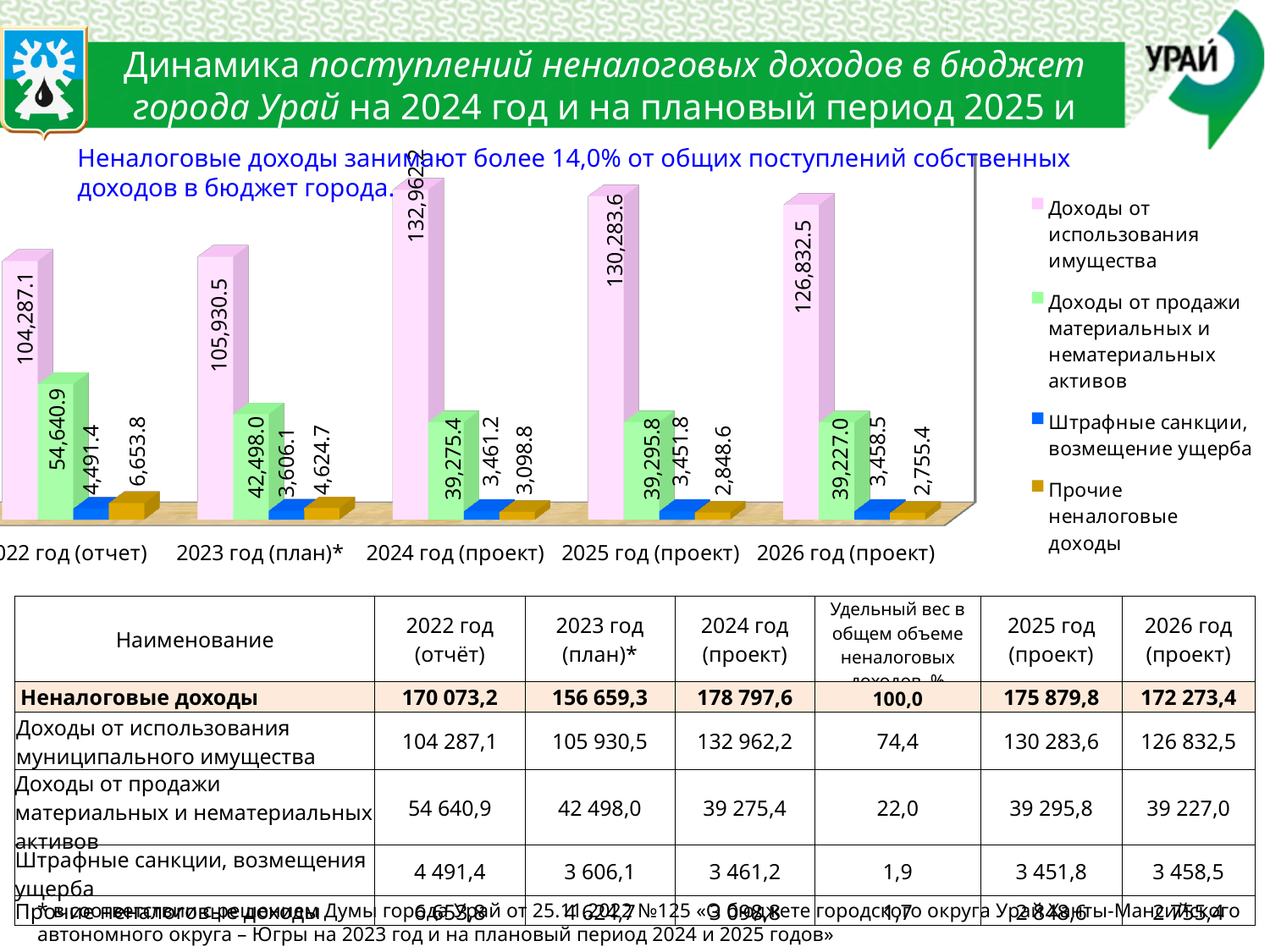
What is the value of Штрафные санкции, возмещение ущерба for 2026 год (проект)? 3,458.5 How many year categories are shown on the chart's x axis? 5 What is the value of Доходы от использования имущества for 2024 год (проект)? 132,962.2 What is the value of Прочие неналоговые доходы for 2025 год (проект)? 2,848.6 Does Прочие неналоговые доходы rise or fall from 2023 год (план)* to 2026 год (проект)? Fall How many series does the chart legend list? 4 What type of chart is shown on the slide? Bar chart What is the value of Доходы от продажи материальных и нематериальных активов for 2023 год (план)*? 42,498.0 What is the difference between Доходы от использования имущества in 2024 год (проект) and 2025 год (проект)? 2,678.6 Which is larger in 2026 год (проект): Штрафные санкции, возмещение ущерба or Прочие неналоговые доходы? Штрафные санкции, возмещение ущерба In which year is Прочие неналоговые доходы the lowest? 2026 год (проект) In which year is Доходы от использования имущества the highest? 2024 год (проект)